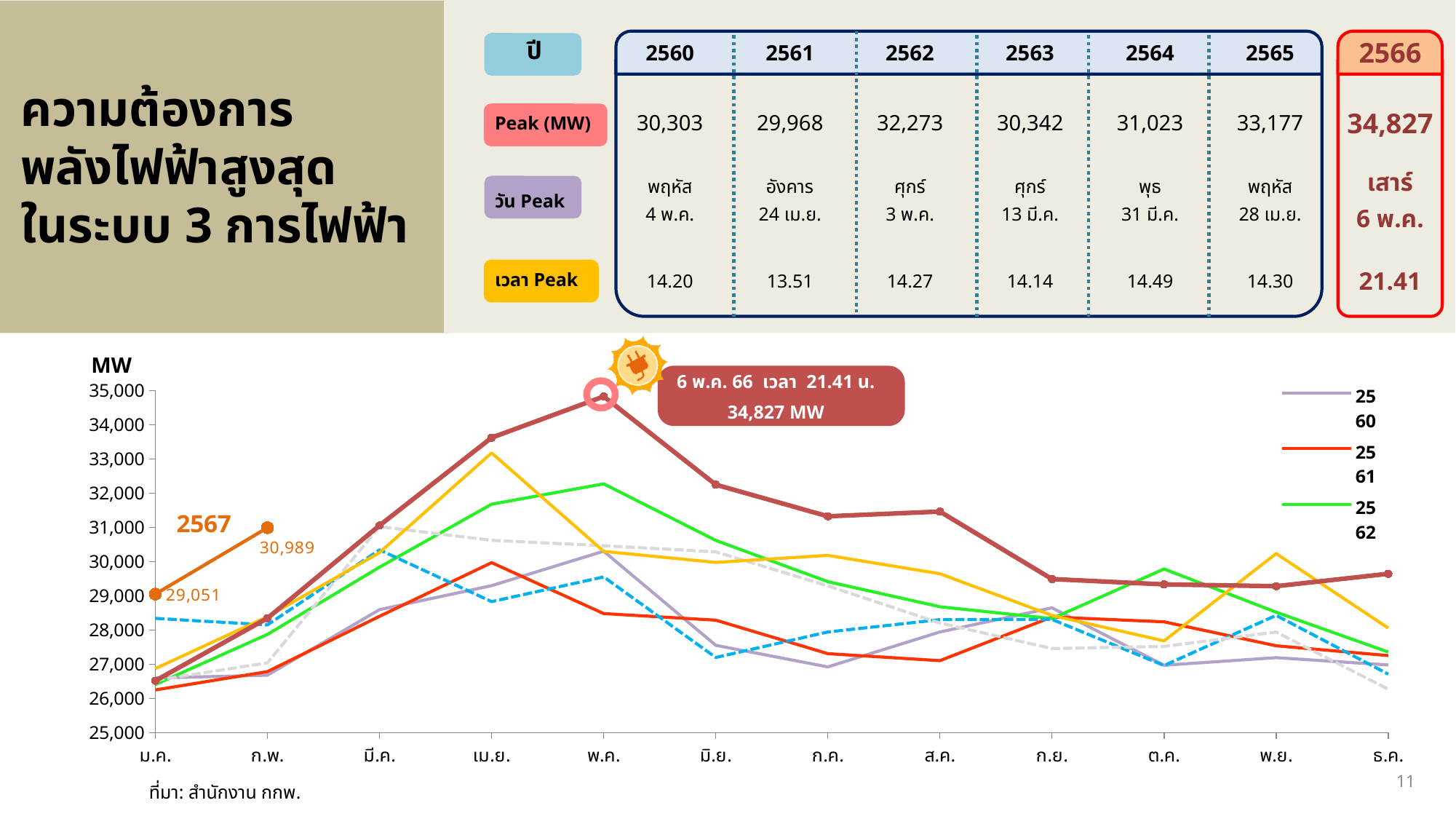
How many months are shown along the x axis of the chart? 12 What is the peak value labelled on the chart for พ.ค. 2566? 34,827 MW Is the value of the 2566 line in ม.ค. greater or less than 27,000? less Which is larger for the 2567 line: the value in ม.ค. or in ก.พ.? ก.พ. In which month does the chart reach its highest value? พ.ค. What unit is labelled on the y axis of the chart? MW Is the value of the 2566 line in พ.ค. greater or less than 34,000? greater What is the value of the 2567 line in ม.ค.? 29,051 What kind of chart is shown on the slide? line chart What is the value of the 2567 line in ก.พ.? 30,989 What is the difference between the 2567 values in ก.พ. and ม.ค.? 1,938 Does the 2567 line rise or fall from ม.ค. to ก.พ.? rise